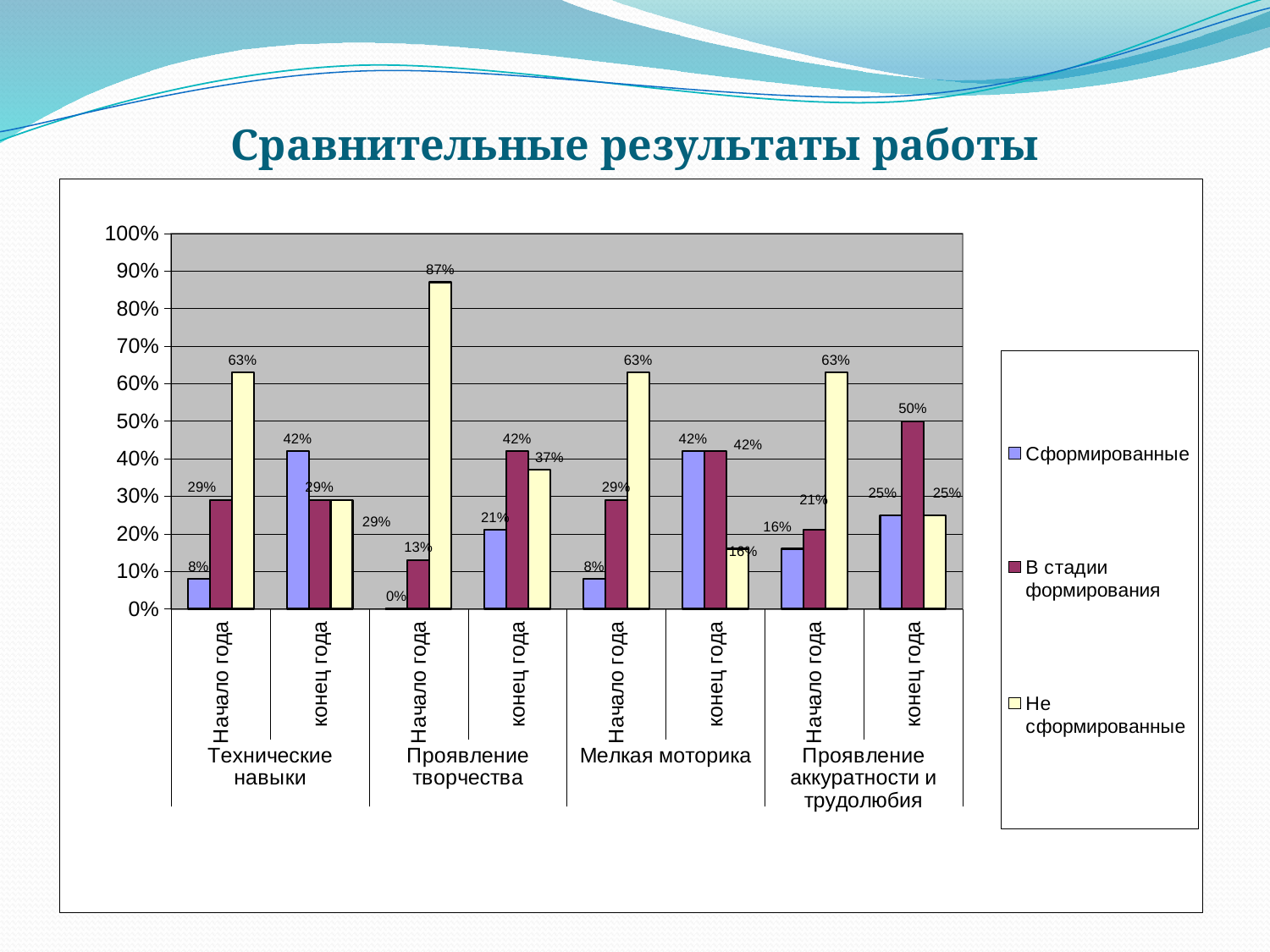
What type of chart is shown on the slide? bar chart Which is larger for "Мелкая моторика" at "конец года": "Сформированные" or "Не сформированные"? Сформированные What is the value of "Не сформированные" for "Проявление творчества" at "Начало года"? 87% What is the value of "Сформированные" for "Технические навыки" at "конец года"? 42% What is the difference between "Не сформированные" for "Технические навыки" at "Начало года" and at "конец года"? 34% Which bar has the highest value in the whole chart? Не сформированные, Проявление творчества, Начало года (87%) Is the value of "Не сформированные" for "Мелкая моторика" at "Начало года" greater or less than 50%? greater What is the title of the slide? Сравнительные результаты работы How many series does the legend list? 3 How many main category groups are shown on the x axis? 4 What is the value of "Сформированные" for "Проявление творчества" at "Начало года"? 0% What is the value of "В стадии формирования" for "Проявление аккуратности и трудолюбия" at "конец года"? 50%